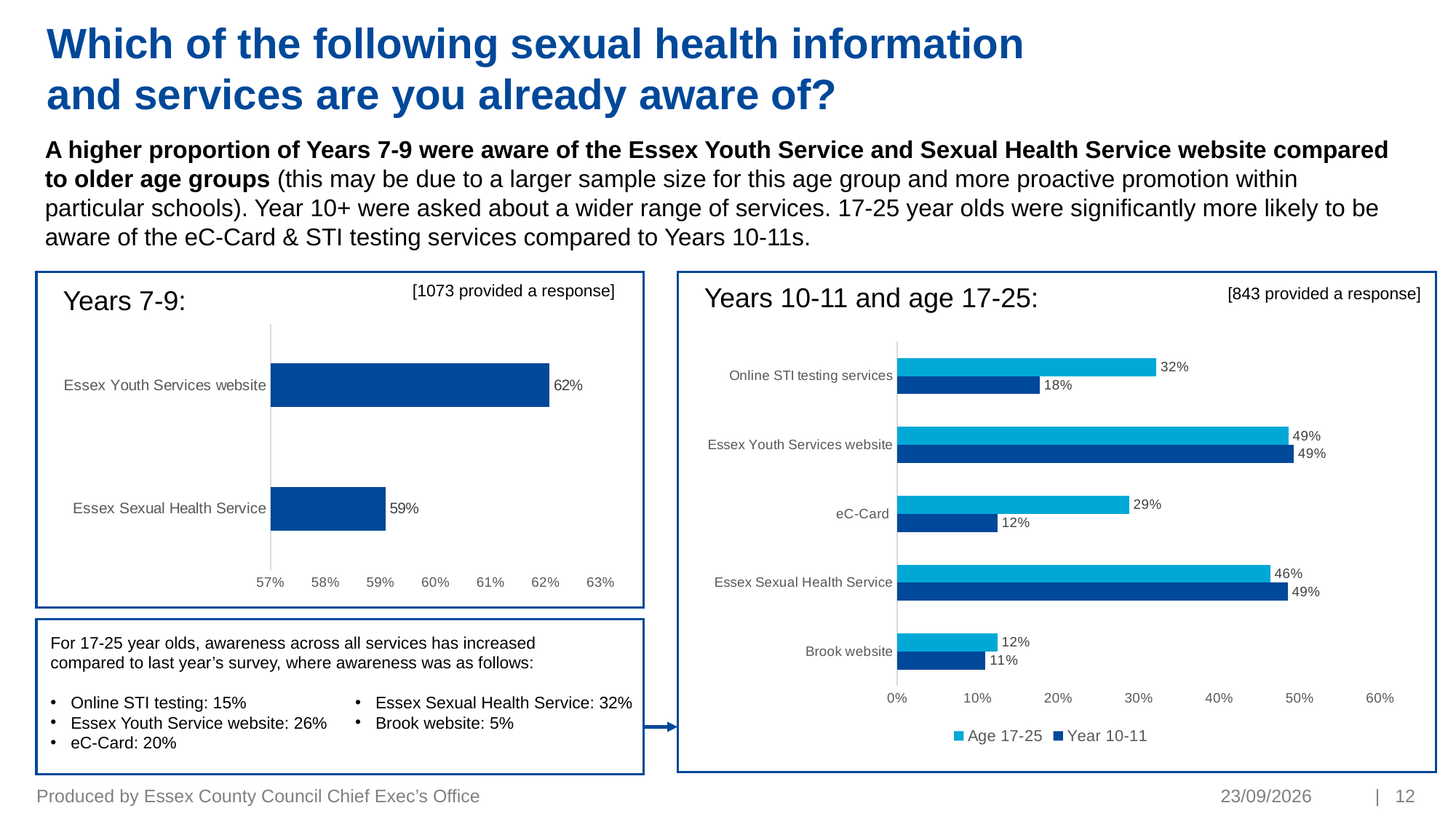
In the Years 10-11 and age 17-25 chart, which service has the highest awareness among Age 17-25? Essex Youth Services website What kind of chart is the Years 7-9 chart? Bar chart In the Years 10-11 and age 17-25 chart, how many services are listed on the axis? 5 In the Years 10-11 and age 17-25 chart, what is the difference between Age 17-25 and Year 10-11 awareness of the eC-Card? 17 percentage points In the Years 10-11 and age 17-25 chart, what percentage of Year 10-11 were aware of the eC-Card? 12% How many series does the legend of the Years 10-11 and age 17-25 chart list? 2 In the Years 7-9 chart, what is the difference between awareness of the Essex Youth Services website and the Essex Sexual Health Service? 3 percentage points In the Years 10-11 and age 17-25 chart, which service has the lowest awareness among Age 17-25? Brook website In the Years 7-9 chart, how many categories are shown? 2 In the Years 10-11 and age 17-25 chart, what percentage of Age 17-25 were aware of Online STI testing services? 32% In the Years 7-9 chart, what percentage were aware of the Essex Youth Services website? 62% In the Years 10-11 and age 17-25 chart, which group has higher awareness of Online STI testing services, Age 17-25 or Year 10-11? Age 17-25